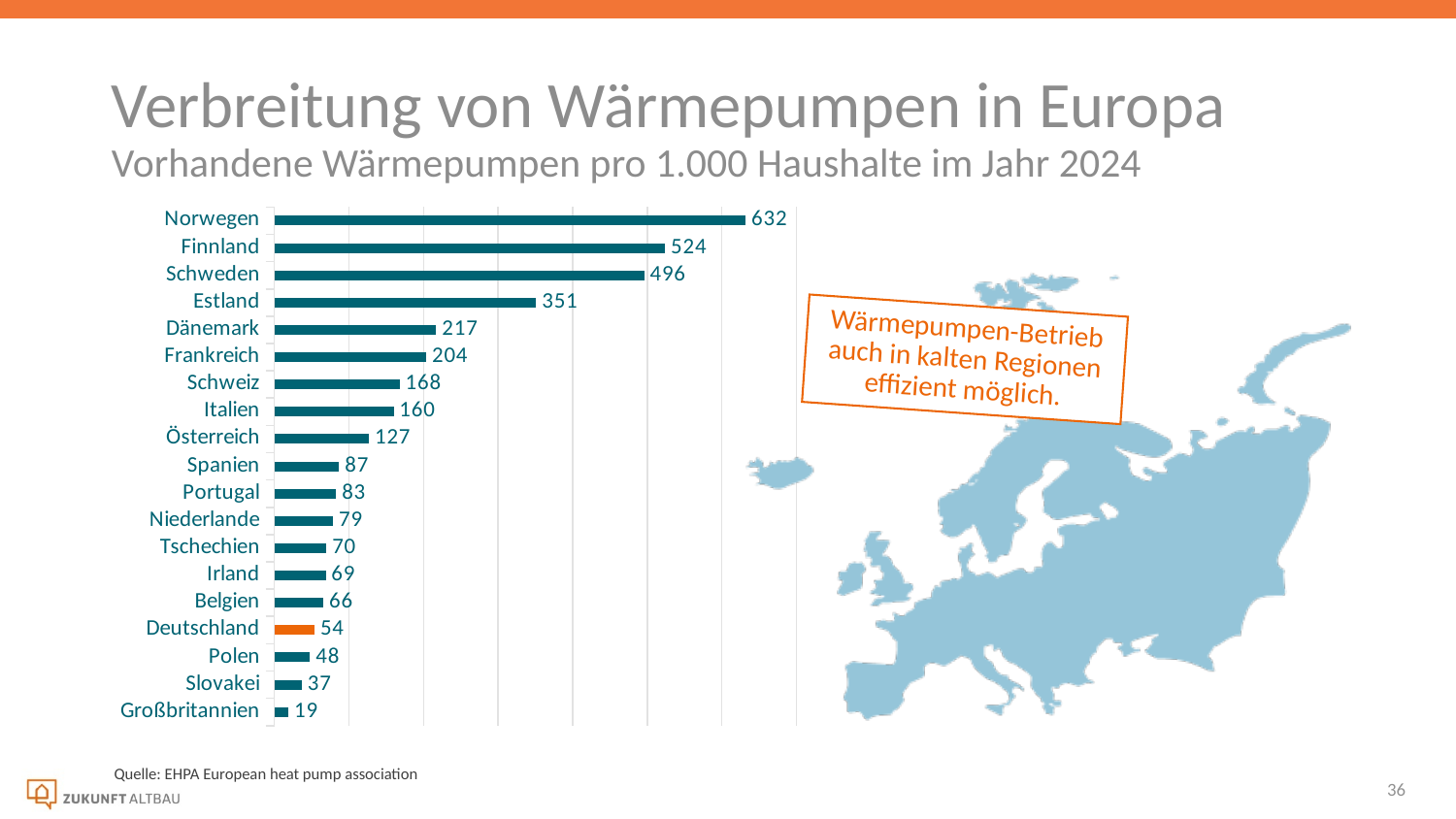
Which country's bar is shown in orange instead of teal? Deutschland How many countries are shown in the chart? 19 What is the difference between the values for Norwegen and Deutschland? 578 What is the value for Norwegen? 632 Which has a larger value, Dänemark or Frankreich? Dänemark Which country has the lowest value? Großbritannien Which country has the highest value? Norwegen What is the value for Schweiz? 168 What is the subtitle of the chart? Vorhandene Wärmepumpen pro 1.000 Haushalte im Jahr 2024 What is the difference between the values for Finnland and Schweden? 28 What is the value for Deutschland? 54 What kind of chart is shown on the slide? Bar chart